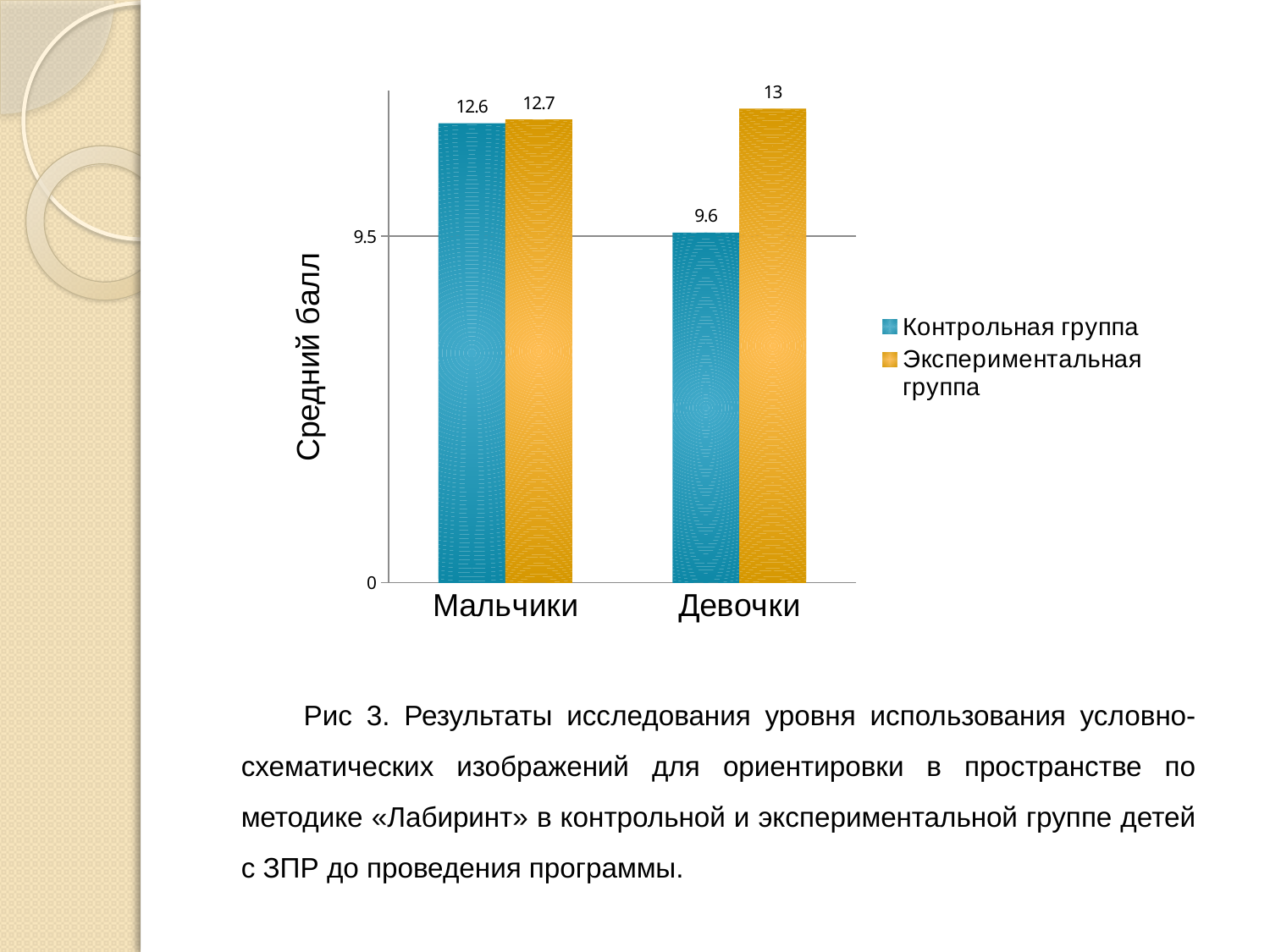
What is the value for Мальчики in the Контрольная группа series? 12.6 How many categories are shown on the x axis? 2 What is the label of the vertical axis? Средний балл Which is larger for Девочки: the Контрольная группа value or the Экспериментальная группа value? Экспериментальная группа Which category has the highest value in the Экспериментальная группа series? Девочки What is the value for Девочки in the Контрольная группа series? 9.6 What is the value for Девочки in the Экспериментальная группа series? 13 What kind of chart is shown on the slide? Bar chart What is the difference between the Экспериментальная группа and Контрольная группа values for Девочки? 3.4 What is the value for Мальчики in the Экспериментальная группа series? 12.7 How many series does the legend list? 2 Which category has the lowest value in the Контрольная группа series? Девочки